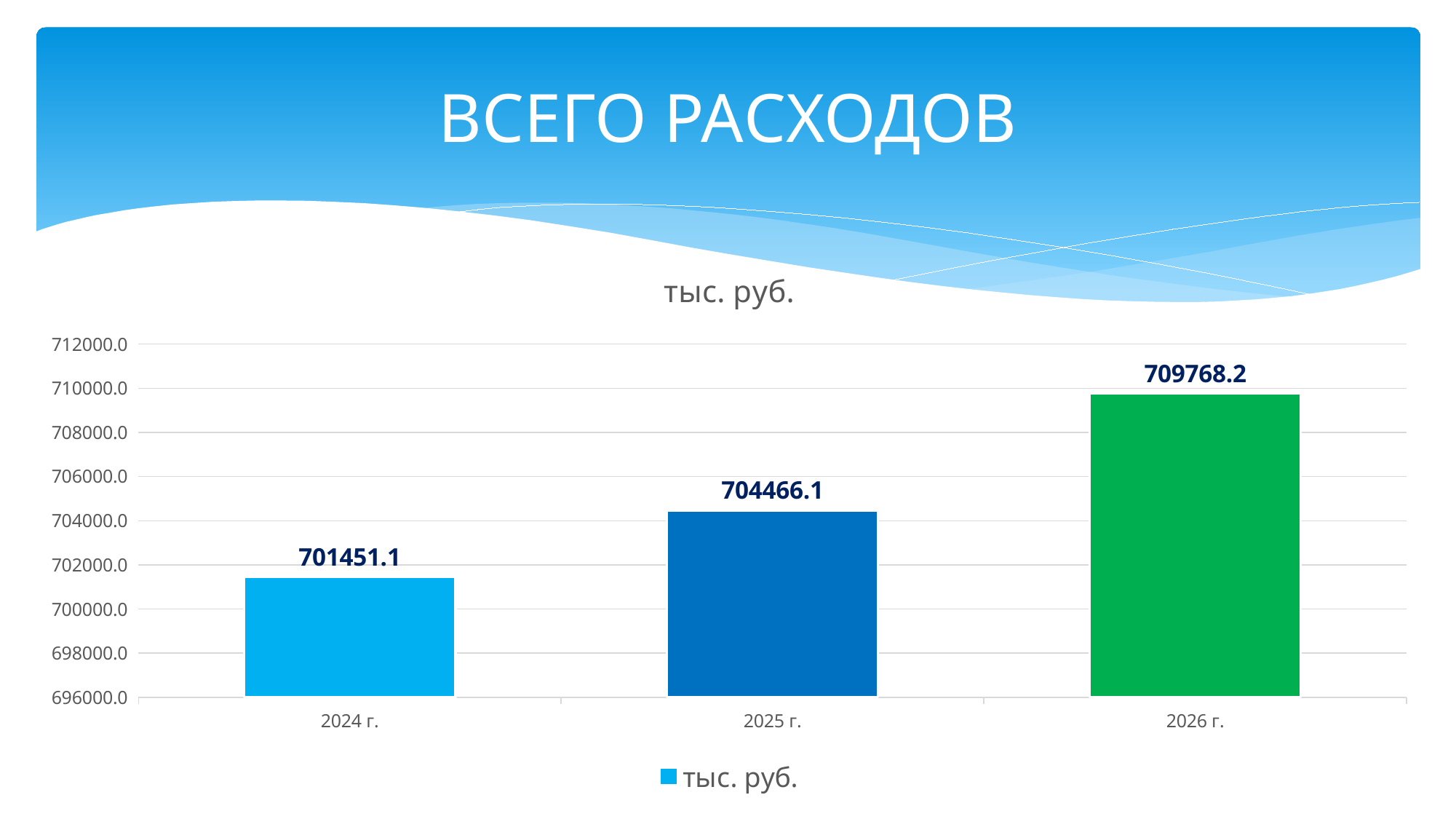
Which is larger, the value for 2025 г. or the value for 2026 г.? 2026 г. What kind of chart is shown on the slide? bar chart What is the value for 2025 г.? 704466.1 What is the difference between the values for 2025 г. and 2024 г.? 3015.0 What is the value for 2026 г.? 709768.2 What is the difference between the values for 2026 г. and 2025 г.? 5302.1 Which year has the lowest value? 2024 г. How many bars are shown in the chart? 3 What is the value for 2024 г.? 701451.1 Do the values rise or fall from 2024 г. to 2026 г.? rise Which year has the highest value? 2026 г. Is the value for 2024 г. greater or less than 702000.0? less